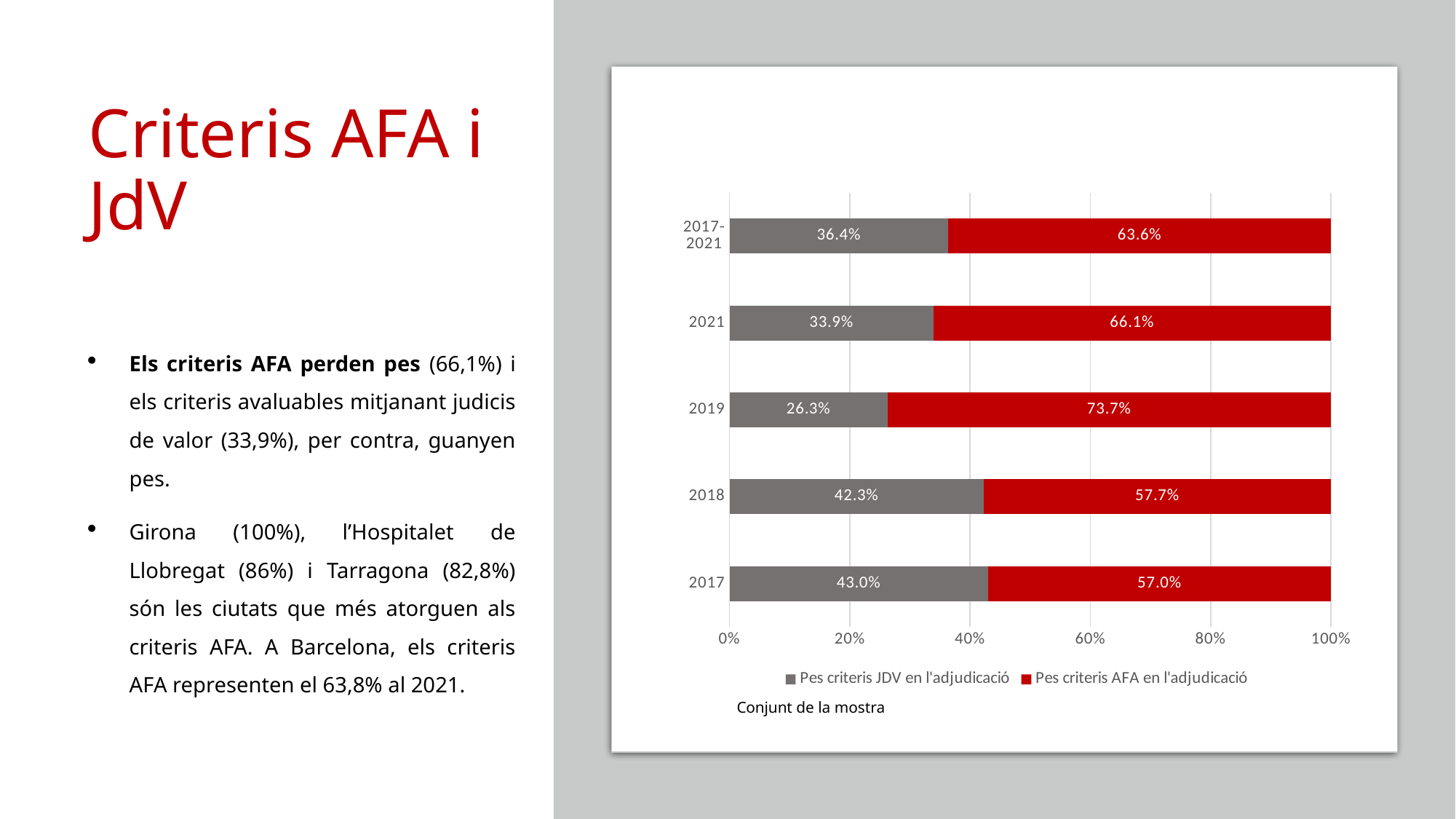
What is the value for 'Pes criteris JDV en l'adjudicació' in 2017? 43.0% What is the value for 'Pes criteris AFA en l'adjudicació' in 2019? 73.7% How many categories are shown on the y axis of the chart? 5 What is the total of the stacked bar for 2018? 100.0% Which is larger: 'Pes criteris JDV en l'adjudicació' in 2018 or in 2021? 2018 How many series does the legend list? 2 Which category has the highest value for 'Pes criteris AFA en l'adjudicació'? 2019 Is the value for 'Pes criteris JDV en l'adjudicació' in 2017 greater or less than 40%? greater Which category has the lowest value for 'Pes criteris JDV en l'adjudicació'? 2019 What kind of chart is shown on the slide? Stacked bar chart What is the value for 'Pes criteris AFA en l'adjudicació' for 2017-2021? 63.6% What is the difference between the 'Pes criteris AFA en l'adjudicació' values for 2021 and 2018? 8.4%